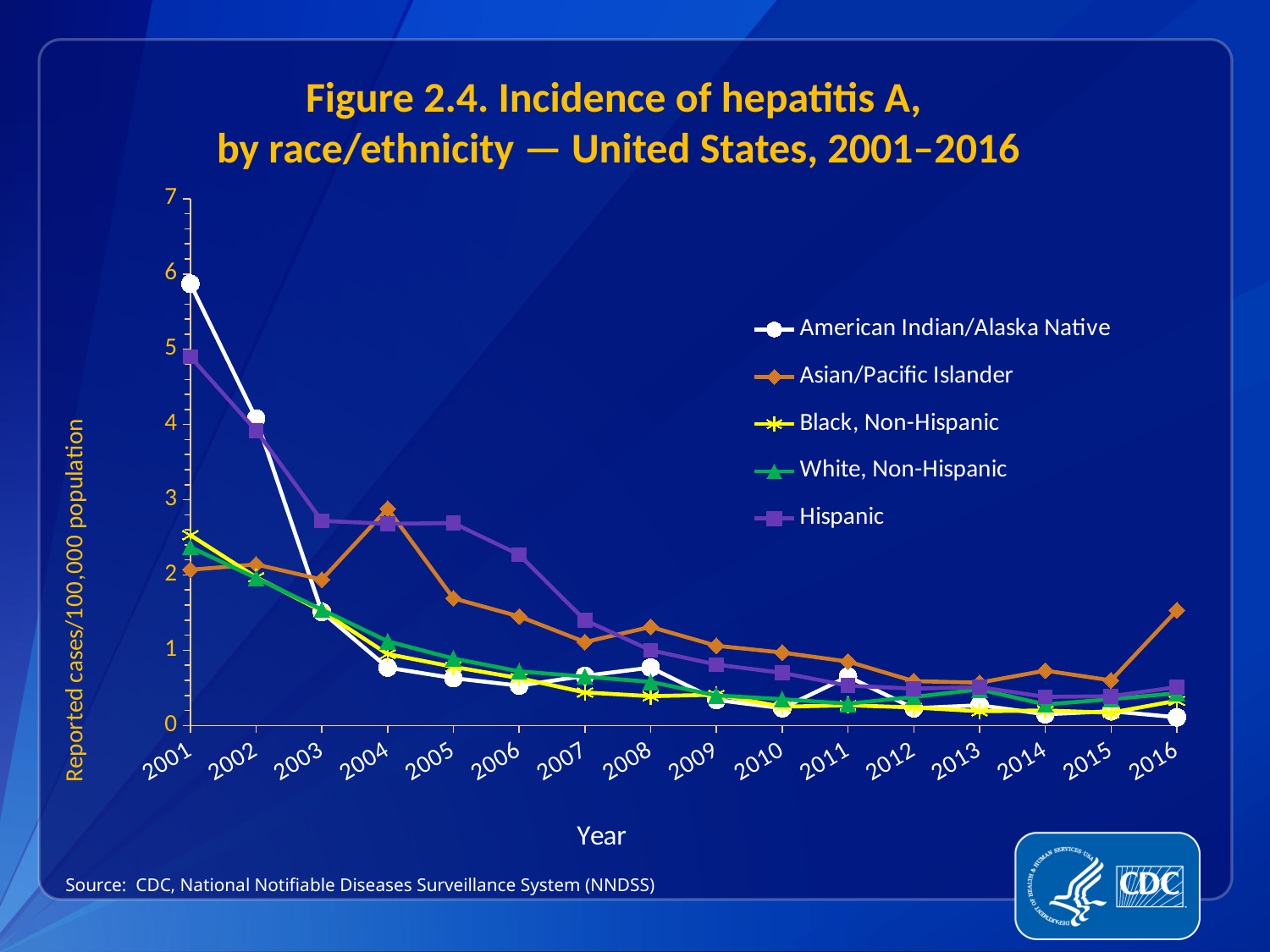
Does the incidence for American Indian/Alaska Native generally rise or fall from 2001 to 2016? fall Is the value for Hispanic in 2001 greater or less than 4? greater What is the label on the y axis? Reported cases/100,000 population What kind of chart is shown on the slide? line chart Which race/ethnicity group had the highest incidence of hepatitis A in 2001? American Indian/Alaska Native Is the value for American Indian/Alaska Native in 2001 greater or less than 5? greater How many series does the legend list? 5 In 2005, which was larger: the value for Hispanic or the value for Asian/Pacific Islander? Hispanic Is the value for Asian/Pacific Islander in 2016 greater or less than 1? greater How many years are plotted along the x axis? 16 Which race/ethnicity group had the highest incidence of hepatitis A in 2016? Asian/Pacific Islander